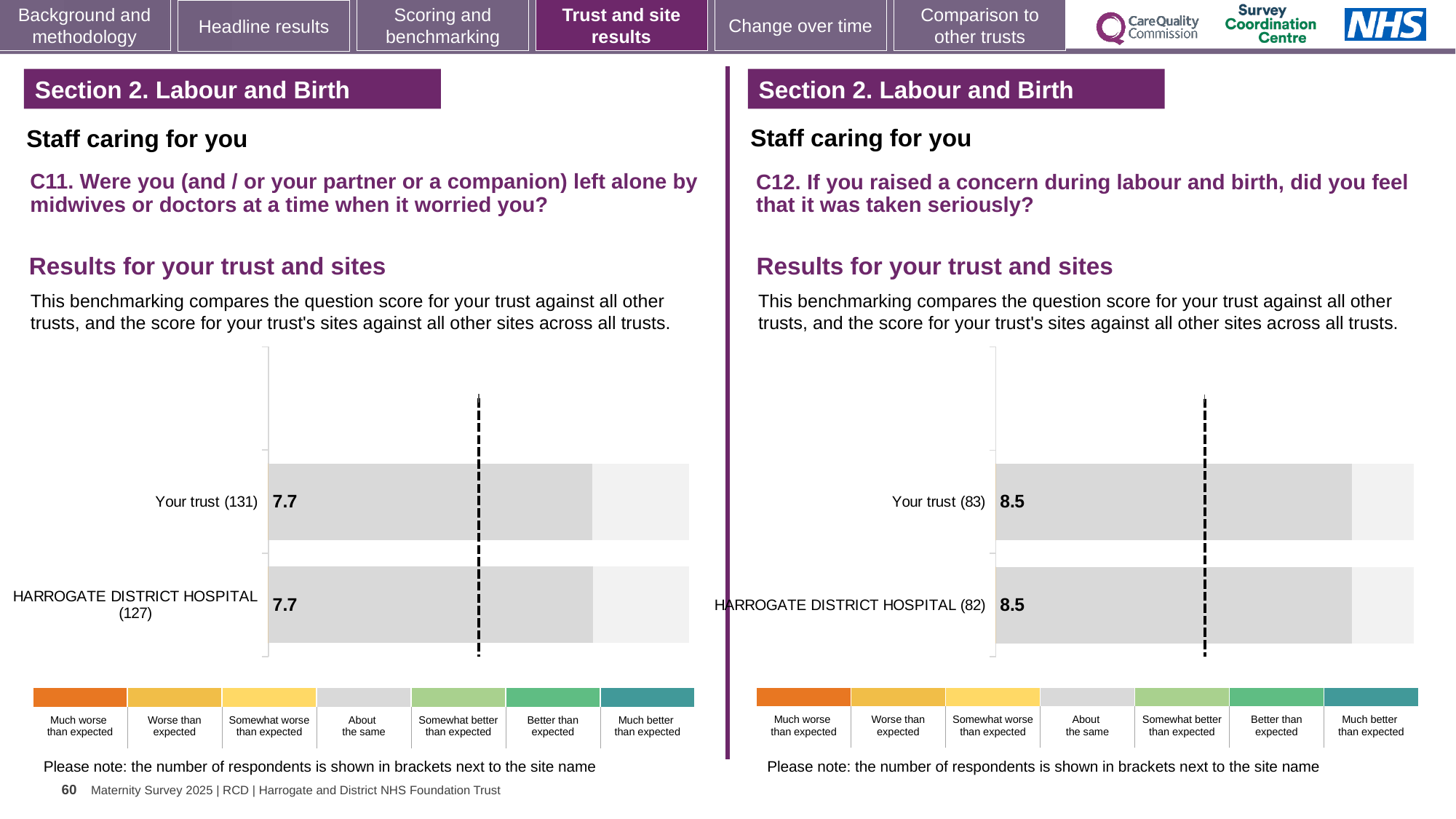
In the C11 chart on the left, what is the score for HARROGATE DISTRICT HOSPITAL? 7.7 In the C11 chart on the left, how many respondents are shown in brackets for Your trust? 131 How many bars are plotted in the C11 chart on the left? 2 How many bars are plotted in the C12 chart on the right? 2 What kind of chart is the C11 chart on the left? Bar chart How many categories does the colour key below the C11 chart on the left list? 7 In the C12 chart on the right, which benchmark category does the grey colour of the bars correspond to in the key below the chart? About the same In the C12 chart on the right, how many respondents are shown in brackets for HARROGATE DISTRICT HOSPITAL? 82 In the C11 chart on the left, what is the difference between the score for Your trust and the score for HARROGATE DISTRICT HOSPITAL? 0.0 In the C12 chart on the right, what is the score for Your trust? 8.5 In the C12 chart on the right, what is the score for HARROGATE DISTRICT HOSPITAL? 8.5 In the C11 chart on the left, what is the score for Your trust? 7.7